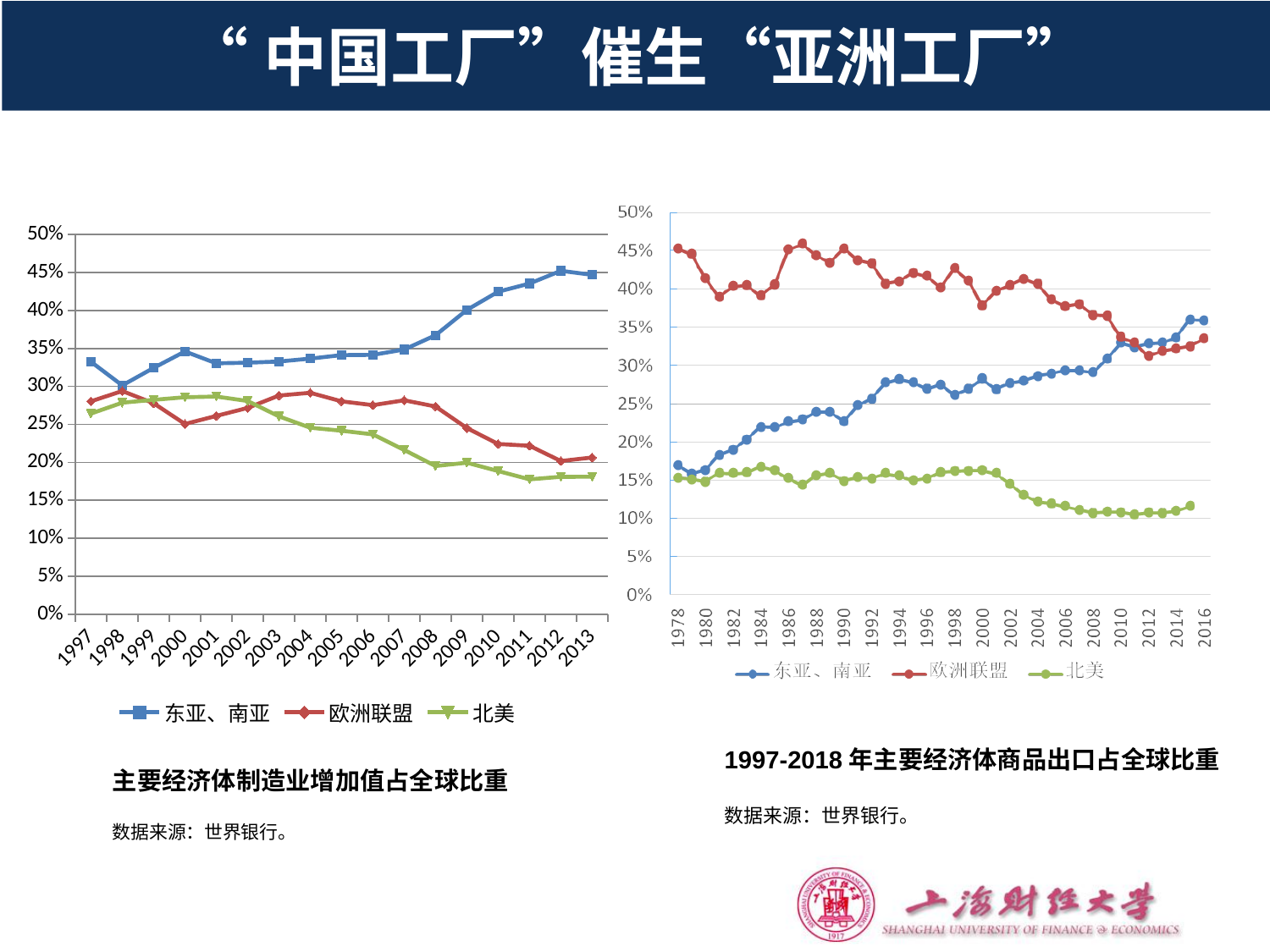
In the right chart, 1997-2018 年主要经济体商品出口占全球比重, is the value for 欧洲联盟 in 2000 greater or less than 40%? less What kind of chart is the left chart, 主要经济体制造业增加值占全球比重? line chart How many series does the legend of the right chart, 1997-2018 年主要经济体商品出口占全球比重, list? 3 How many years are shown on the x axis of the left chart, 主要经济体制造业增加值占全球比重? 17 In the left chart, 主要经济体制造业增加值占全球比重, which series has the highest value in 2013? 东亚、南亚 In the right chart, 1997-2018 年主要经济体商品出口占全球比重, does the 欧洲联盟 series rise or fall overall from 1978 to 2016? fall In the right chart, 1997-2018 年主要经济体商品出口占全球比重, which is larger in 1978: 欧洲联盟 or 北美? 欧洲联盟 In the right chart, 1997-2018 年主要经济体商品出口占全球比重, is the value for 东亚、南亚 in 1978 greater or less than 20%? less In the left chart, 主要经济体制造业增加值占全球比重, does the 东亚、南亚 series rise or fall from 1997 to 2013? rise In the left chart, 主要经济体制造业增加值占全球比重, is the value for 东亚、南亚 in 2013 greater or less than 40%? greater